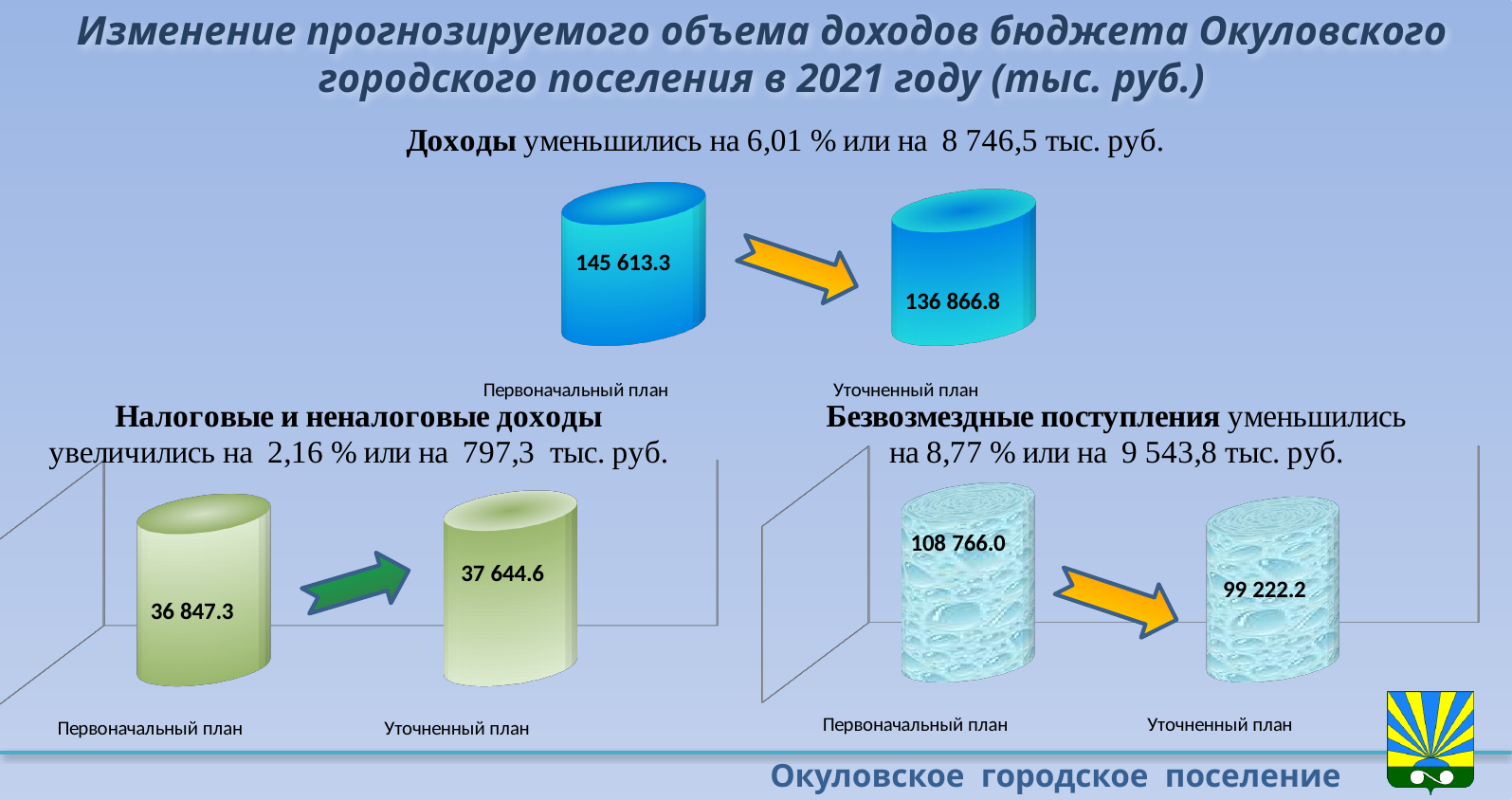
In the bottom-right chart (Безвозмездные поступления), what is the value for Уточненный план? 99 222.2 In the bottom-left chart (Налоговые и неналоговые доходы), what is the value for Первоначальный план? 36 847.3 In the top chart (Доходы), what is the value for Уточненный план? 136 866.8 In the bottom-left chart (Налоговые и неналоговые доходы), what is the value for Уточненный план? 37 644.6 In the bottom-right chart (Безвозмездные поступления), what is the value for Первоначальный план? 108 766.0 In the bottom-right chart (Безвозмездные поступления), do the values rise or fall from Первоначальный план to Уточненный план? fall In the bottom-left chart (Налоговые и неналоговые доходы), which is larger: Первоначальный план or Уточненный план? Уточненный план In the top chart (Доходы), what is the value for Первоначальный план? 145 613.3 In the bottom-left chart (Налоговые и неналоговые доходы), by how much does Уточненный план exceed Первоначальный план? 797.3 In the bottom-right chart (Безвозмездные поступления), what is the difference between Первоначальный план and Уточненный план? 9 543.8 In the top chart (Доходы), what is the difference between Первоначальный план and Уточненный план? 8 746.5 How many categories does the top chart (Доходы) show? 2